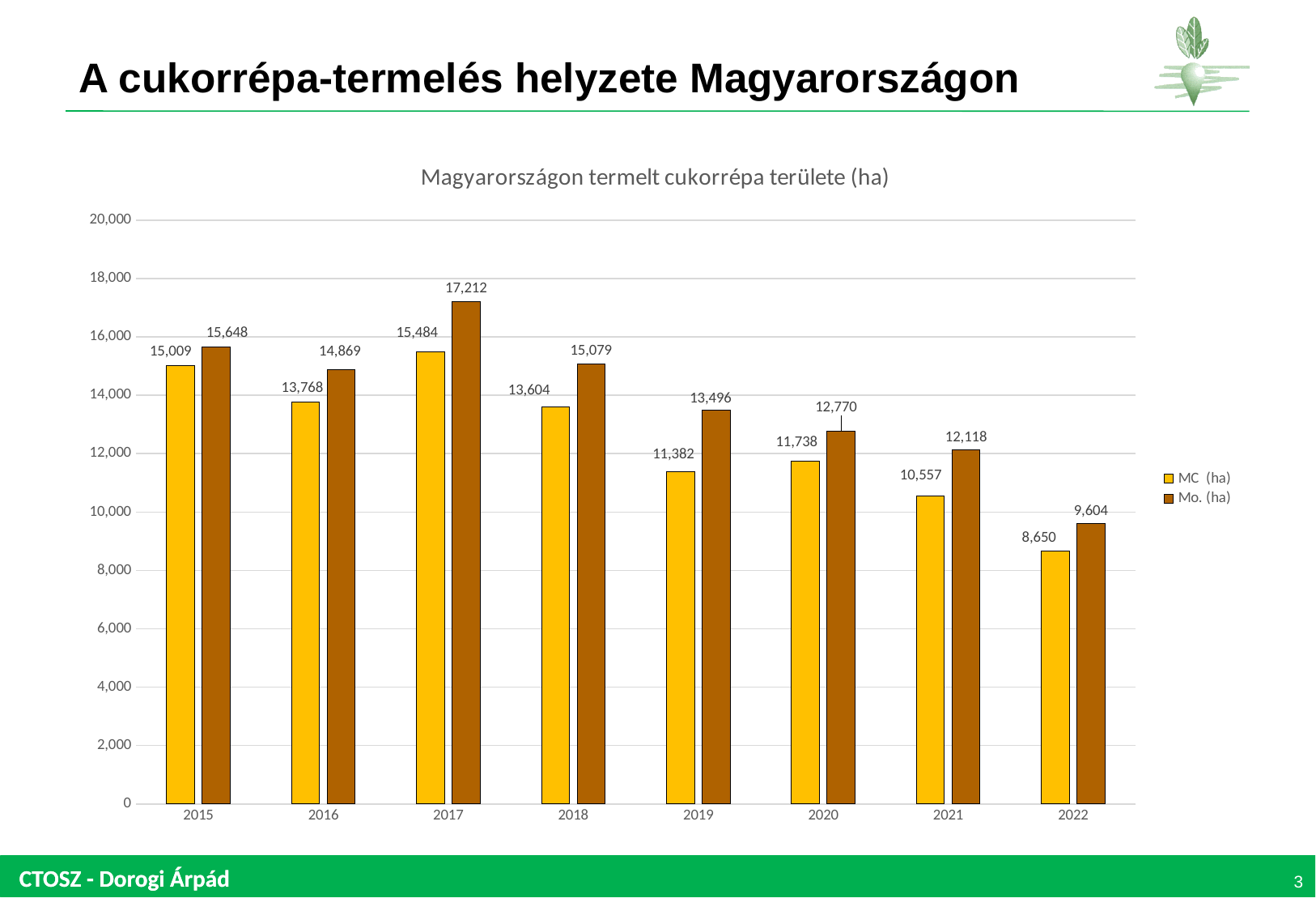
How many series does the legend list? 2 Which year has the lowest MC (ha) value? 2022 What is the MC (ha) value for 2017? 15,484 Is the MC (ha) value for 2021 greater or less than 12,000? less What kind of chart is shown on the slide? bar chart Which is larger in 2019: the MC (ha) value or the Mo. (ha) value? Mo. (ha) What is the title of the chart? Magyarországon termelt cukorrépa területe (ha) How many years are shown on the x axis? 8 Which year has the highest Mo. (ha) value? 2017 What is the difference between the Mo. (ha) and MC (ha) values in 2015? 639 Do the Mo. (ha) values generally rise or fall from 2017 to 2022? fall What is the Mo. (ha) value for 2020? 12,770